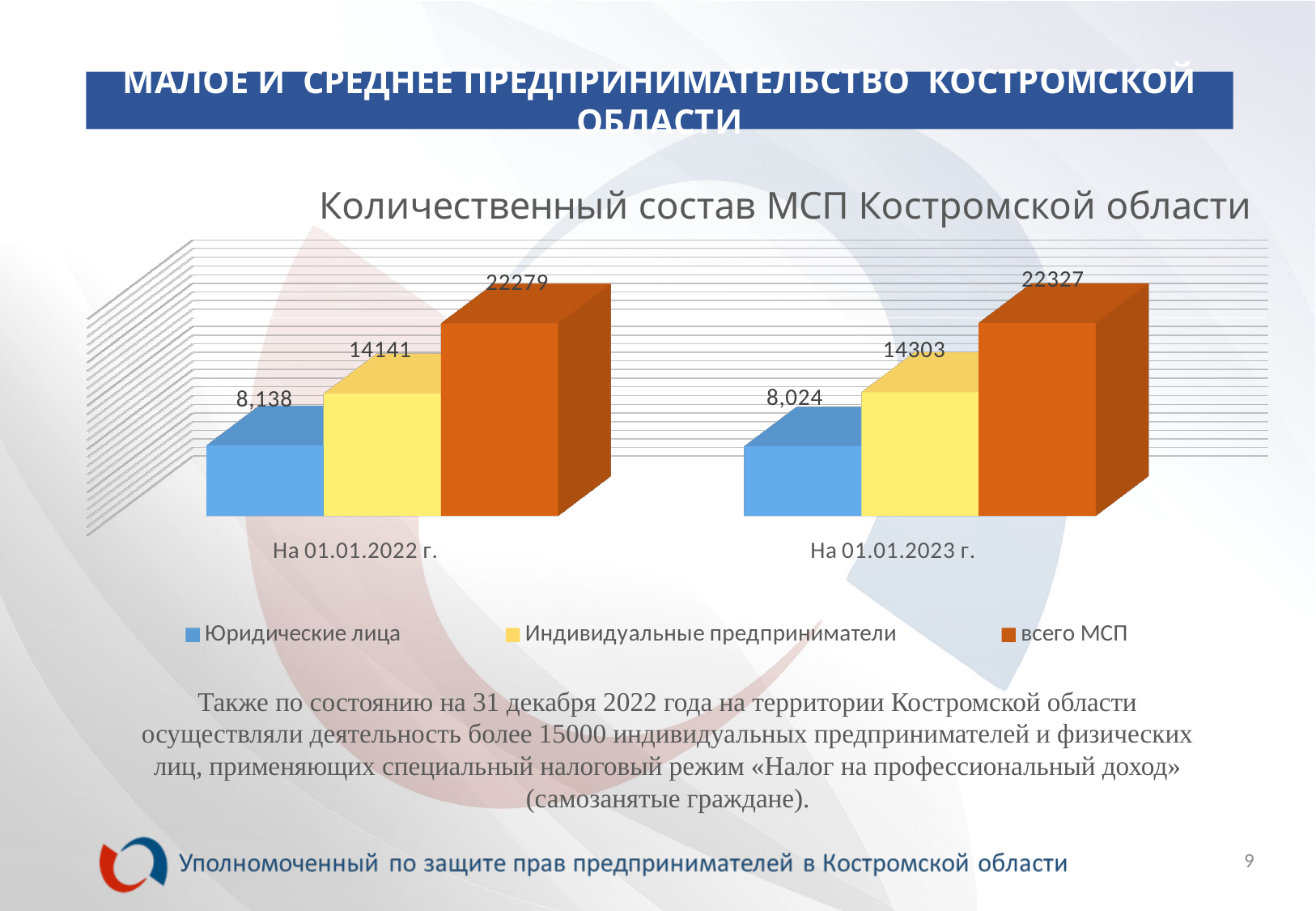
Which is larger: Юридические лица on 01.01.2022 or on 01.01.2023? 01.01.2022 What is the value for всего МСП on 01.01.2022? 22279 What is the title of the chart? Количественный состав МСП Костромской области How many series does the legend list? 3 Which series has the lowest value on 01.01.2022? Юридические лица Which series has the highest value on 01.01.2023? всего МСП What is the difference between Индивидуальные предприниматели on 01.01.2023 and on 01.01.2022? 162 What is the difference between всего МСП on 01.01.2023 and on 01.01.2022? 48 What is the value for Юридические лица on 01.01.2022? 8,138 What is the value for всего МСП on 01.01.2023? 22327 What is the value for Индивидуальные предприниматели on 01.01.2023? 14303 What kind of chart is shown? Bar chart